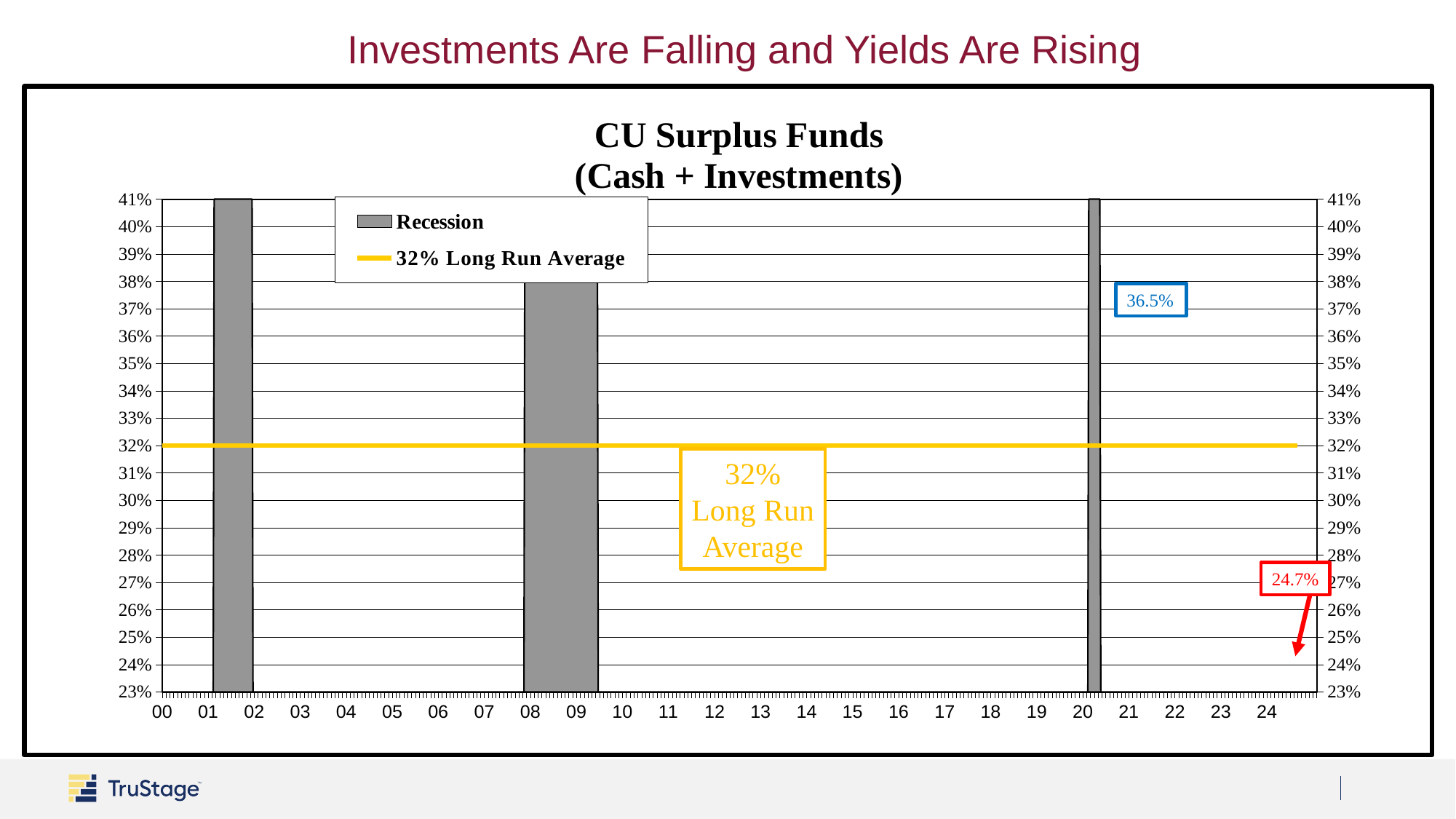
What is the title of the chart? CU Surplus Funds (Cash + Investments) Is the annotated value 24.7% greater or less than the 32% long run average? less How many entries does the chart legend list? 2 What value is shown in the blue annotation box near year 21? 36.5% What is the highest value shown on the vertical axis? 41% How many shaded recession bars are shown on the chart? 3 What is the difference between the annotated values 36.5% and 24.7%? 11.8 percentage points What is the lowest value shown on the vertical axis? 23% Which annotated value is larger, the one near year 21 or the one near year 24? The one near year 21 (36.5%) Is the annotated value 36.5% greater or less than the 32% long run average? greater What value is shown in the red annotation box near year 24? 24.7% What value is the long run average line drawn at? 32%